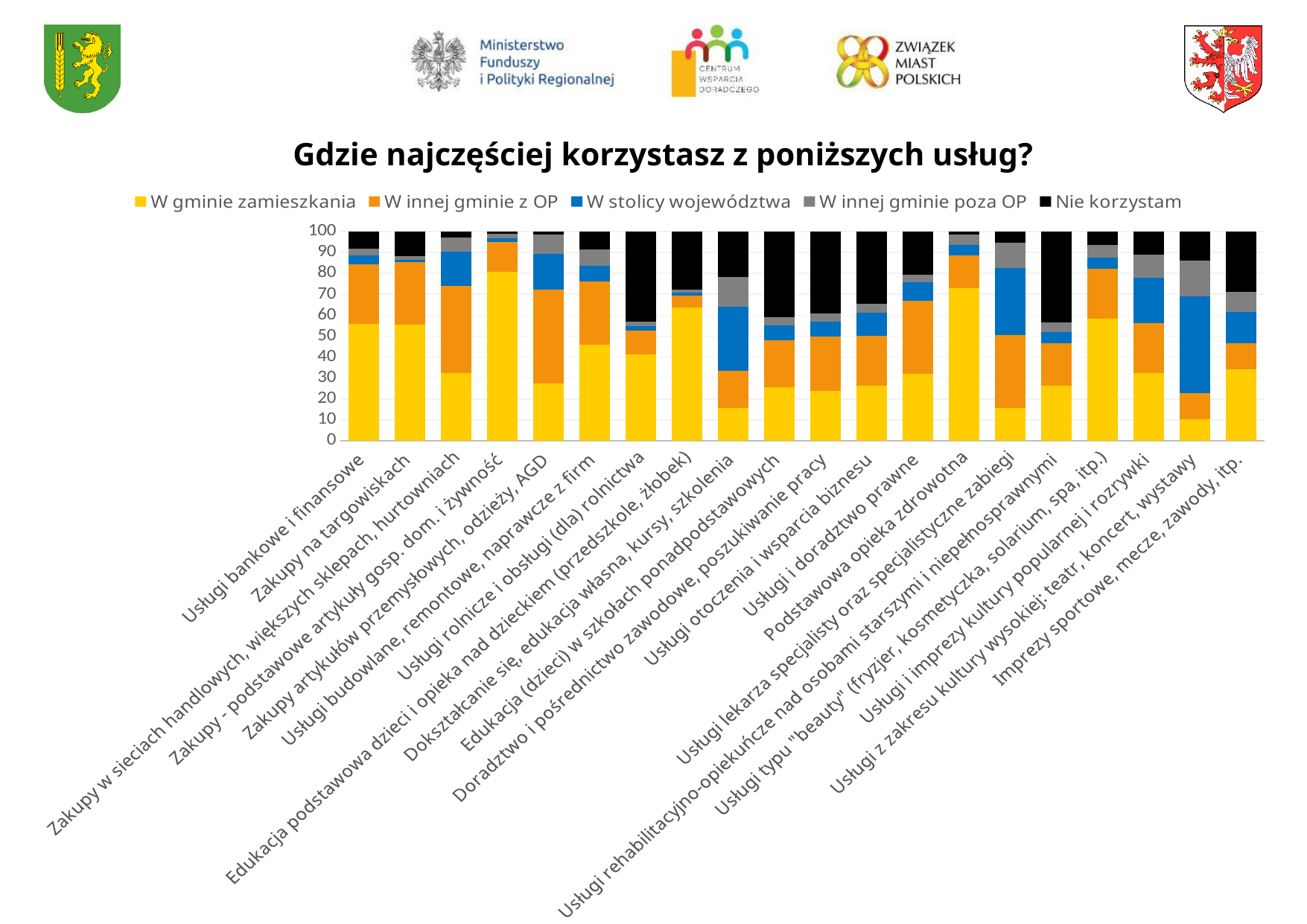
How many service categories are plotted along the x axis? 20 Is the 'W gminie zamieszkania' value for 'Usługi bankowe i finansowe' greater or less than 50? greater Which legend entry is shown in black? Nie korzystam How many series does the legend list? 5 What is the title of the chart? Gdzie najczęściej korzystasz z poniższych usług? Is the 'W gminie zamieszkania' value for 'Zakupy - podstawowe artykuły gosp. dom. i żywność' greater or less than 70? greater Is the 'W gminie zamieszkania' value for 'Usługi z zakresu kultury wysokiej: teatr, koncert, wystawy' greater or less than 20? less What kind of chart is shown on the slide? stacked bar chart Which has a larger 'W stolicy województwa' share: 'Usługi z zakresu kultury wysokiej: teatr, koncert, wystawy' or 'Zakupy na targowiskach'? Usługi z zakresu kultury wysokiej: teatr, koncert, wystawy Which has a larger 'W gminie zamieszkania' share: 'Usługi bankowe i finansowe' or 'Zakupy w sieciach handlowych, większych sklepach, hurtowniach'? Usługi bankowe i finansowe Which category has the largest 'W gminie zamieszkania' share? Zakupy - podstawowe artykuły gosp. dom. i żywność